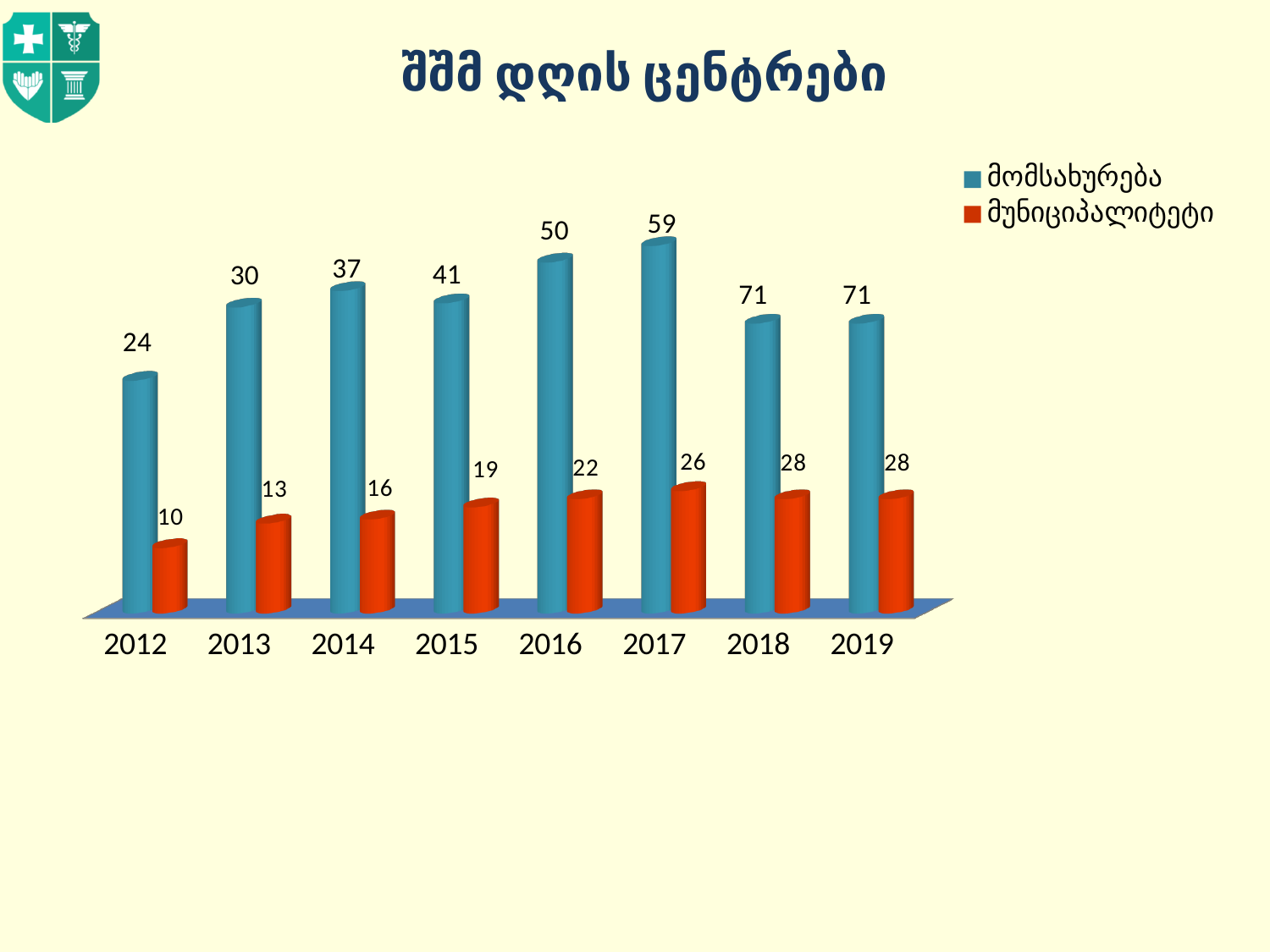
What is the value for მუნიციპალიტეტი in 2017? 26 What is the value for მომსახურება in 2016? 50 What type of chart is shown on the slide? bar chart How many years are shown on the x axis? 8 In which year is the value for მუნიციპალიტეტი lowest? 2012 What is the difference between the მომსახურება values for 2017 and 2016? 9 What is the value for მუნიციპალიტეტი in 2014? 16 How many series does the legend list? 2 In which year is the value for მომსახურება lowest? 2012 What is the value for მომსახურება in 2012? 24 Which is larger in 2013, the value for მომსახურება or for მუნიციპალიტეტი? მომსახურება What is the difference between the მომსახურება and მუნიციპალიტეტი values in 2015? 22